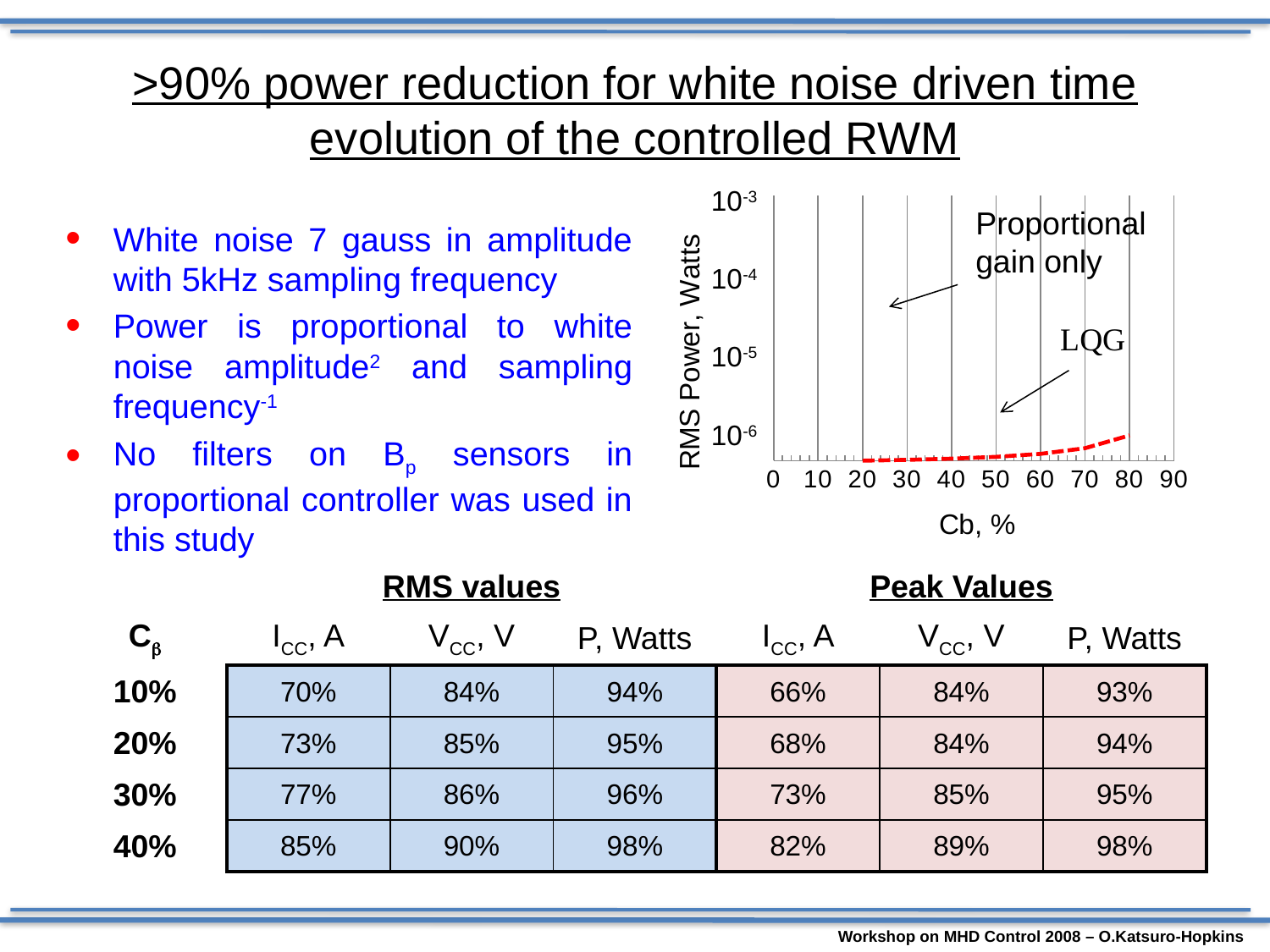
At which Cb value does the LQG curve reach its highest RMS power? 80 What is the label of the y axis of the chart? RMS Power, Watts What is the highest value shown on the y axis of the chart? 10^-3 What is the lowest value shown on the y axis of the chart? 10^-6 How many series are labelled on the chart? 2 Is the RMS power of the LQG curve at Cb = 60% greater or less than 10^-5 Watts? less Does the LQG curve rise or fall as Cb increases from 20 to 80? rise What is the label of the x axis of the chart? Cb, % What kind of chart is shown on the slide? line chart Is the RMS power of the LQG curve at Cb = 40% greater or less than 10^-6 Watts? less What is the highest value shown on the x axis of the chart? 90